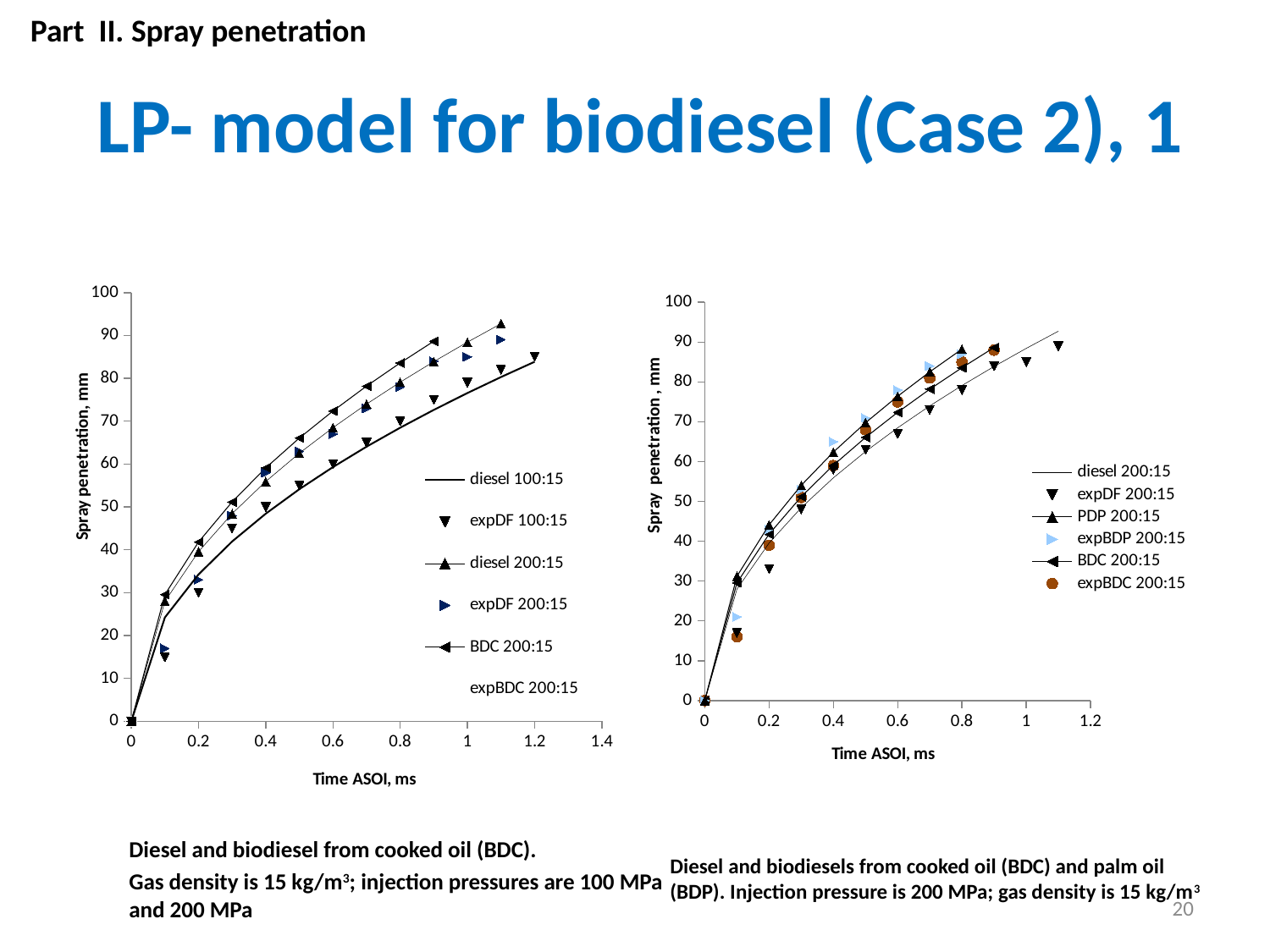
How many series does the legend of the left chart list? 6 What is the x-axis title of the right chart? Time ASOI, ms In the left chart, is the expDF 100:15 value at 0.1 ms greater or less than 20? less In the left chart, at 1.0 ms, which is larger: the diesel 200:15 value or the diesel 100:15 value? diesel 200:15 In the left chart, do the spray penetration values rise or fall as Time ASOI increases? Rise How many series does the legend of the right chart list? 6 In the left chart, is the diesel 100:15 value at 1.2 ms greater or less than 90? less What kind of chart is the left chart on the slide? Line chart with scatter markers In the right chart, do the spray penetration values rise or fall as Time ASOI increases? Rise In the right chart, is the expBDC 200:15 value at 0.1 ms greater or less than 20? less In the right chart, at 0.4 ms, which is larger: the expBDP 200:15 value or the expDF 200:15 value? expBDP 200:15